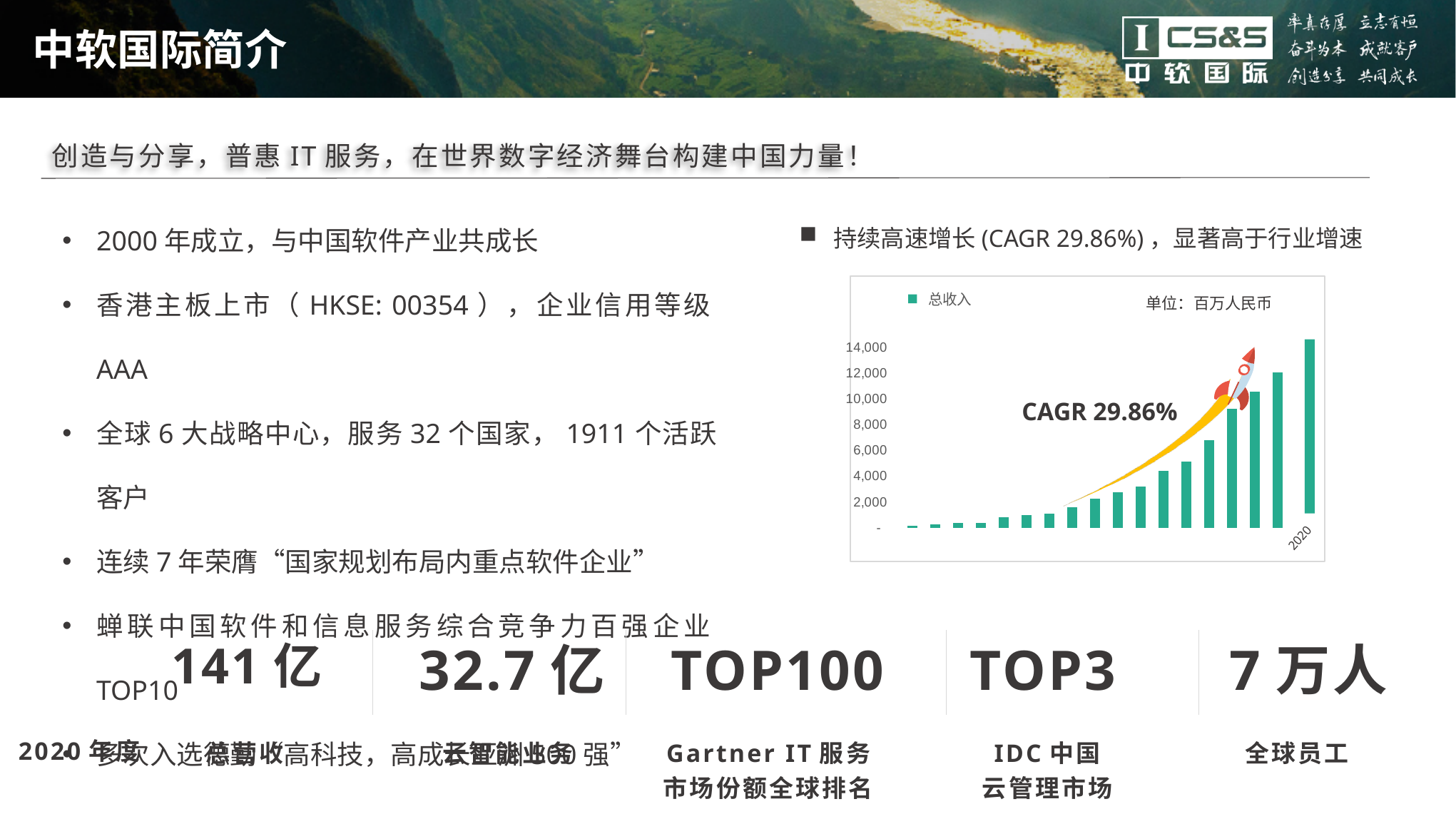
What series name is shown in the chart's legend? 总收入 Is the value for 2020 greater or less than 12,000? greater What unit is stated for the values in the chart? 百万人民币 What kind of chart is shown on the slide? bar chart How many series does the chart's legend list? 1 Do the bar values rise or fall from left to right along the x axis? rise Is the value for 2020 greater or less than 10,000? greater What CAGR is annotated on the chart? CAGR 29.86% Which year has the highest bar in the chart? 2020 Is the value of the leftmost bar greater or less than 2,000? less